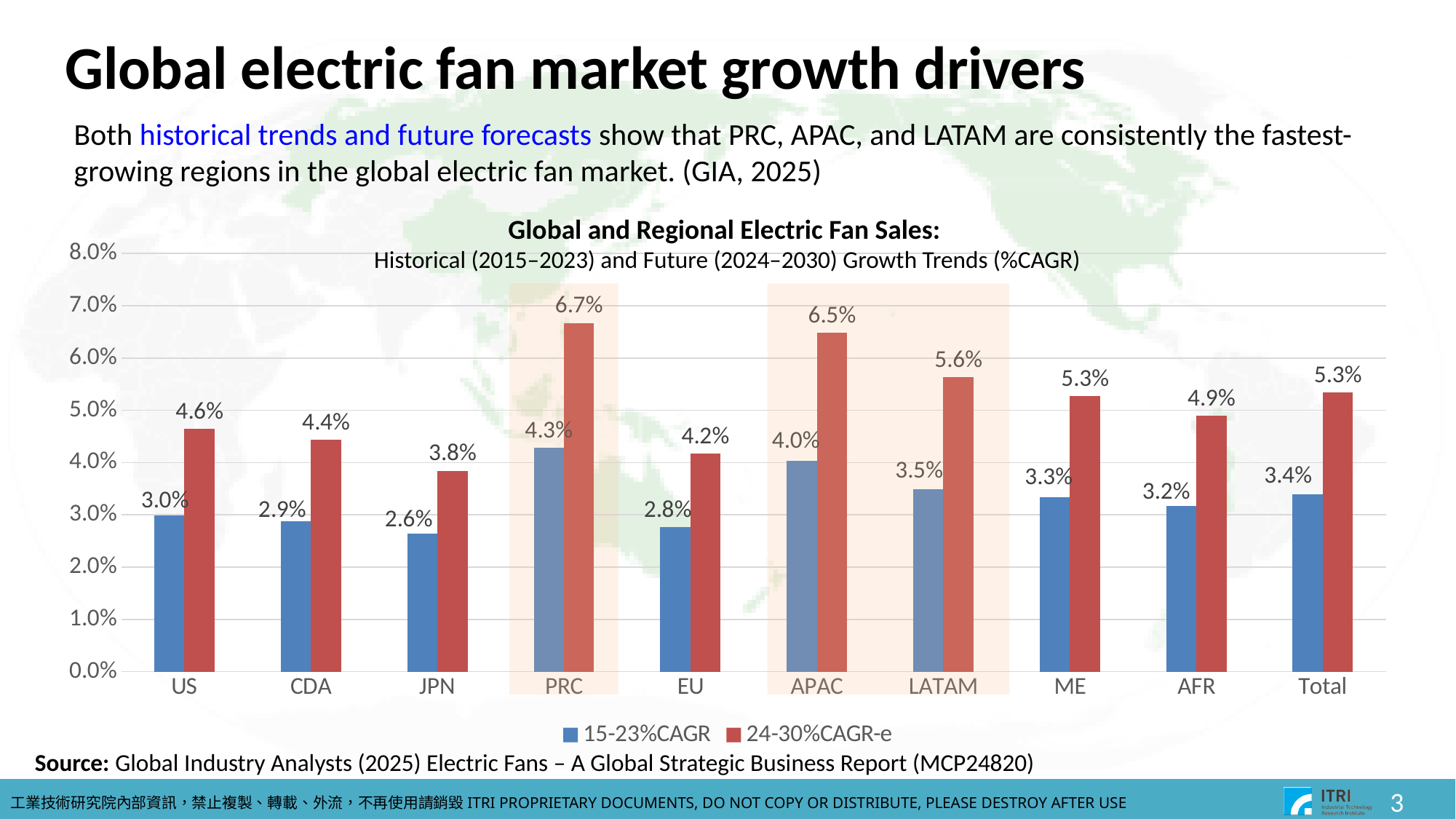
Which is larger, the 15-23%CAGR value for APAC or for ME? APAC Which category has the highest 24-30%CAGR-e value? PRC What is the difference between the 24-30%CAGR-e values for APAC and EU? 2.3% What is the difference between the 24-30%CAGR-e and 15-23%CAGR values for PRC? 2.4% What is the 15-23%CAGR value for PRC? 4.3% Which series is shown in red in the legend? 24-30%CAGR-e What is the 24-30%CAGR-e value for Total? 5.3% How many categories are shown on the x axis? 10 Which category has the lowest 15-23%CAGR value? JPN What kind of chart is shown on the slide? Bar chart How many series does the legend list? 2 What is the 24-30%CAGR-e value for LATAM? 5.6%